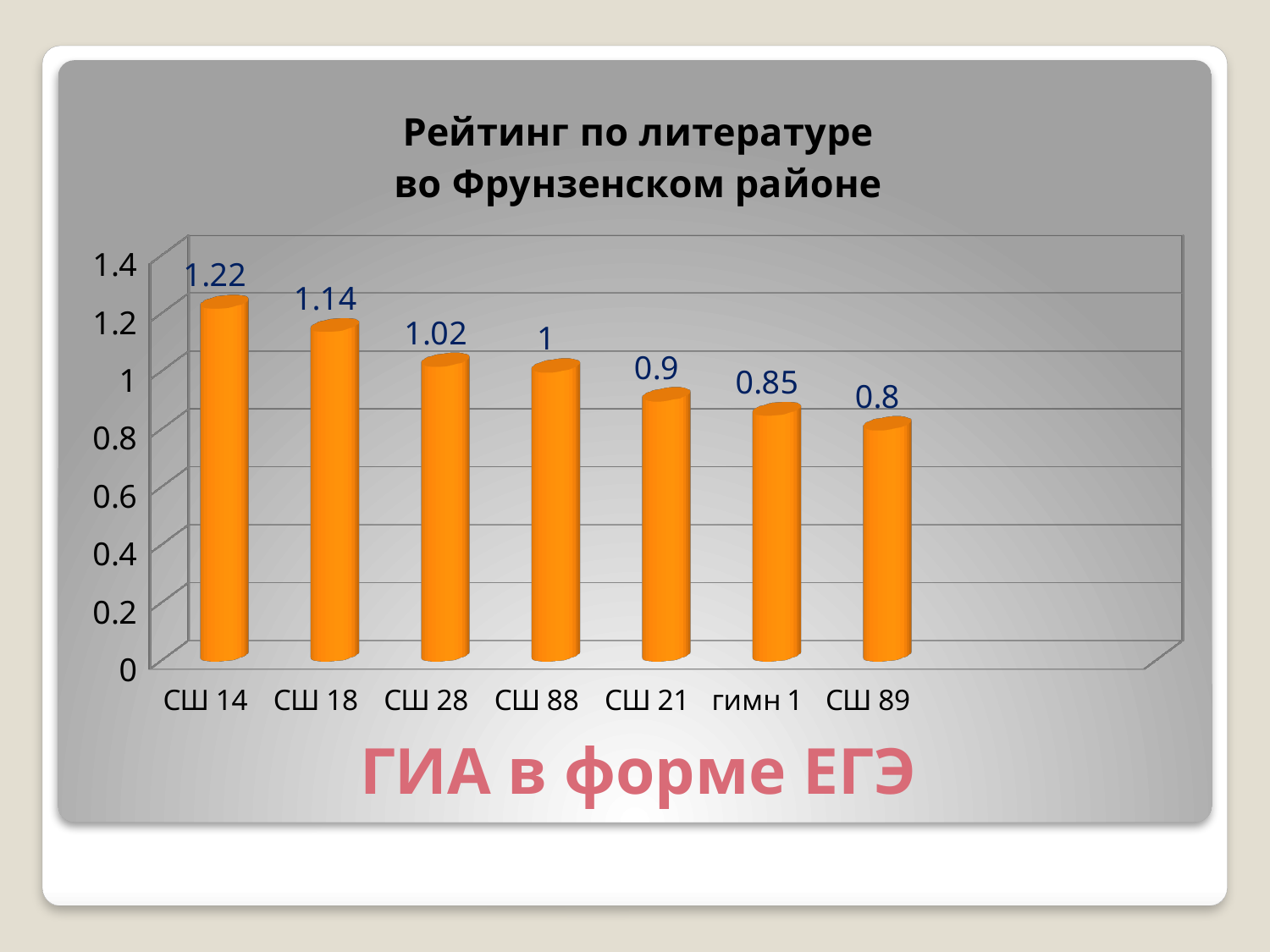
What is the value for СШ 14? 1.22 Is the value for СШ 18 greater or less than 1? greater What is the difference between the values for СШ 18 and СШ 28? 0.12 What is the value for СШ 21? 0.9 Which is larger, the value for СШ 88 or the value for СШ 21? СШ 88 Which category has the highest value? СШ 14 What is the difference between the values for СШ 14 and СШ 89? 0.42 Do the values rise or fall from left to right along the x axis? fall How many categories are shown on the x axis? 7 Which category has the lowest value? СШ 89 What is the value for гимн 1? 0.85 What kind of chart is shown on the slide? bar chart